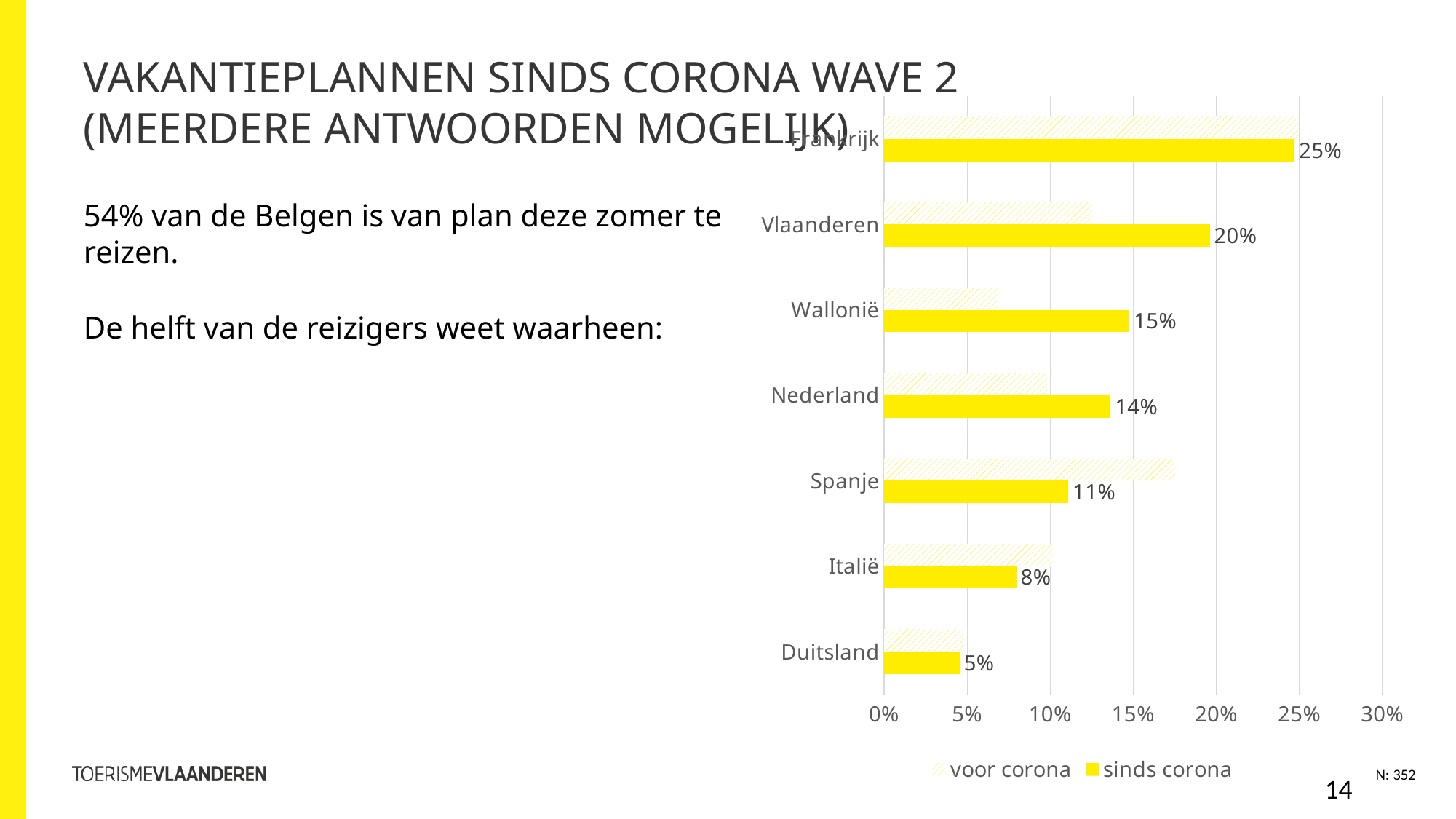
What is the 'sinds corona' value for Duitsland? 5% What kind of chart is shown on the slide? Bar chart What is the 'sinds corona' value for Nederland? 14% What is the 'sinds corona' value for Frankrijk? 25% Is the 'voor corona' value for Spanje greater or less than 15%? greater Which destination has the lowest 'sinds corona' value? Duitsland What is the difference between the 'sinds corona' values for Vlaanderen and Wallonië? 5% Is the 'voor corona' value for Wallonië greater or less than 10%? less Which has a larger 'sinds corona' value, Spanje or Italië? Spanje How many series does the legend list? 2 Which destination has the highest 'sinds corona' value? Frankrijk How many destinations are shown on the chart? 7